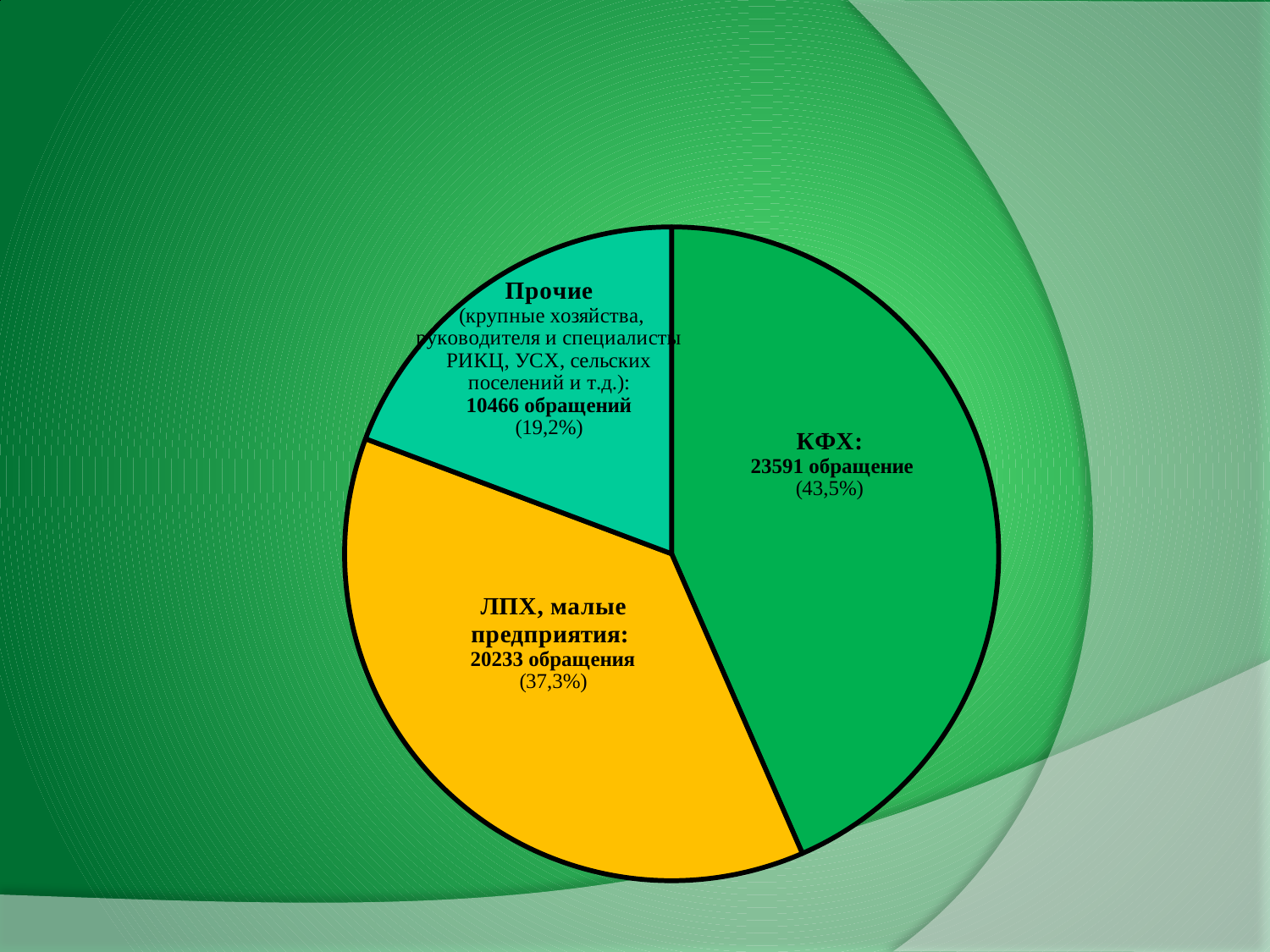
Which category has the smallest slice of the pie? Прочие Which has more обращений: ЛПХ, малые предприятия or Прочие? ЛПХ, малые предприятия What share of the pie does КФХ account for? 43,5% How many обращений are shown for КФХ? 23591 How many обращений are shown for Прочие? 10466 What is the difference in обращений between КФХ and ЛПХ, малые предприятия? 3358 How many slices does the pie chart have? 3 What colour is the slice for ЛПХ, малые предприятия? yellow Which category has the largest slice of the pie? КФХ How many обращений are shown for ЛПХ, малые предприятия? 20233 What kind of chart is shown on the slide? pie chart What share of the pie does Прочие account for? 19,2%